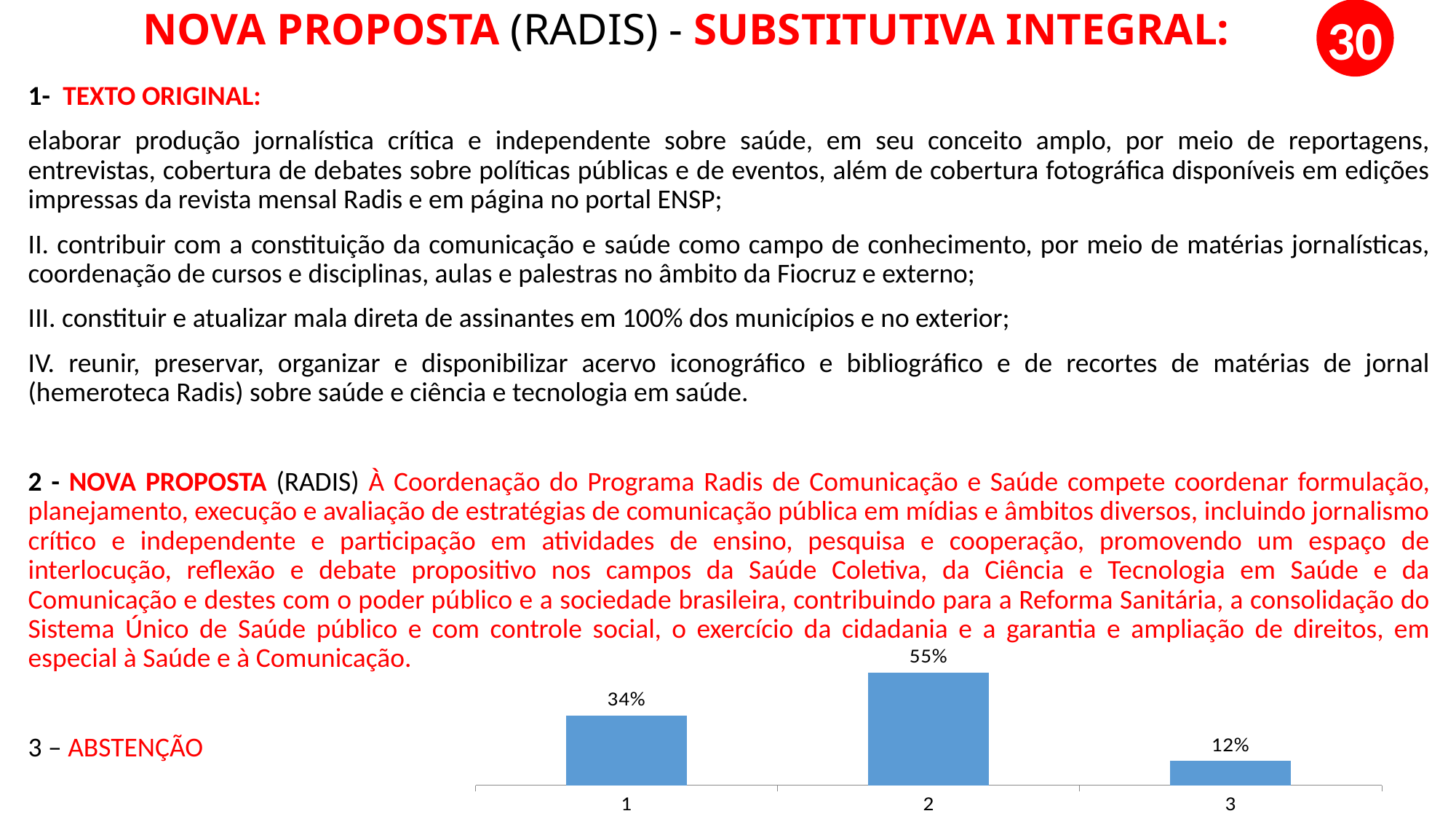
What is the total of the three values shown in the bar chart? 101% Which category has the lowest value in the bar chart? 3 How many categories are shown in the bar chart? 3 Which category has the highest value in the bar chart? 2 What is the value for category 3 in the bar chart? 12% What is the value for category 2 in the bar chart? 55% What colour are the bars in the chart? blue What kind of chart is shown on the slide? bar chart What is the difference between the values for category 2 and category 1? 21% Which is larger, the value for category 1 or the value for category 3? 1 What is the difference between the values for category 1 and category 3? 22% What is the value for category 1 in the bar chart? 34%